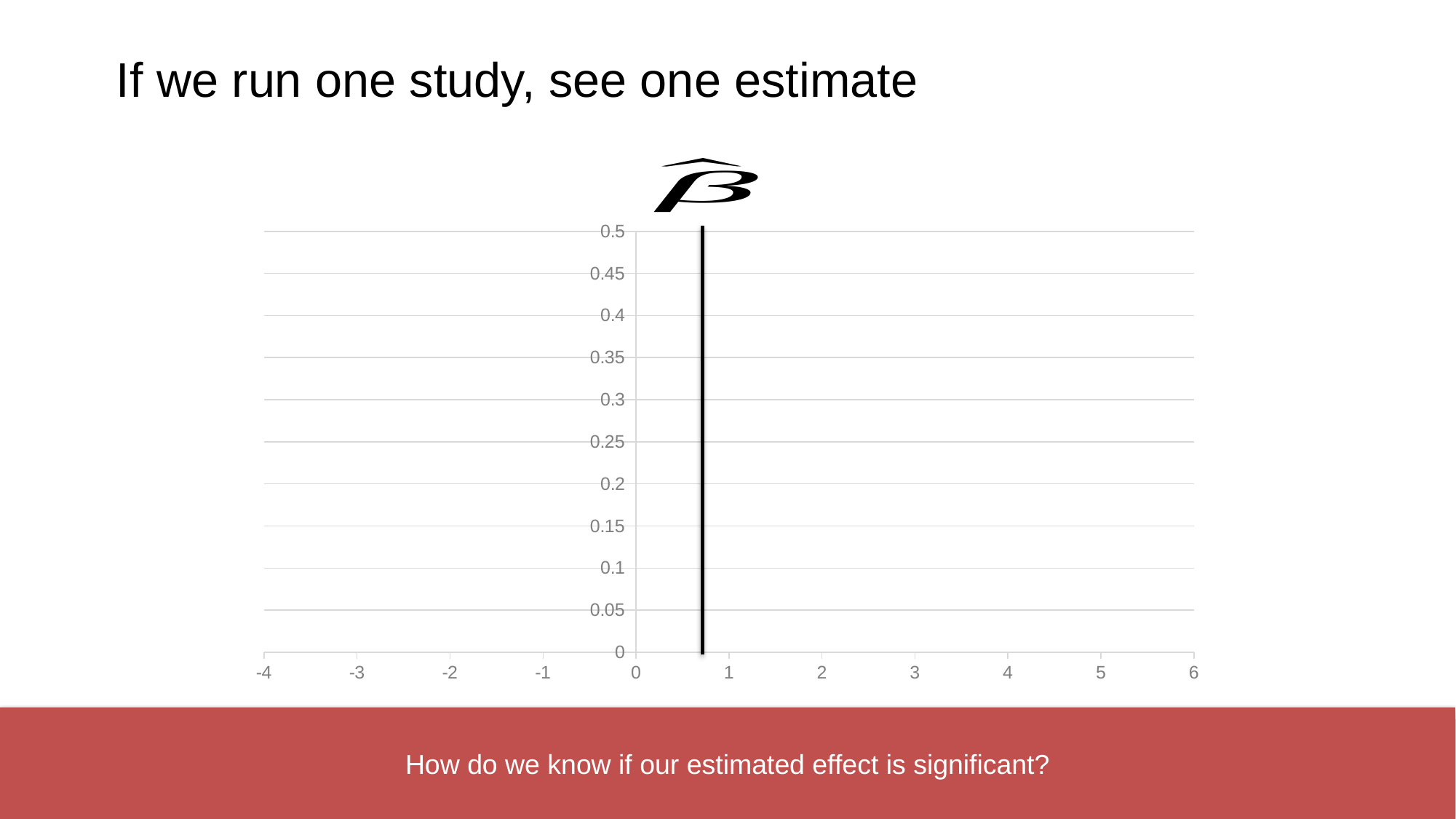
Is the x-axis position of the vertical line (the estimate) greater or less than 1? less How many estimates (vertical lines) are plotted on the chart? 1 Is the x-axis position of the vertical line (the estimate) greater or less than 0? greater What is the highest value shown on the x axis of the chart? 6 Does the vertical line on the chart lie to the left or to the right of 0 on the x axis? right What is the lowest value shown on the x axis of the chart? -4 What is the highest tick value shown on the y axis of the chart? 0.5 Is the x-axis position of the vertical line (the estimate) greater or less than 2? less